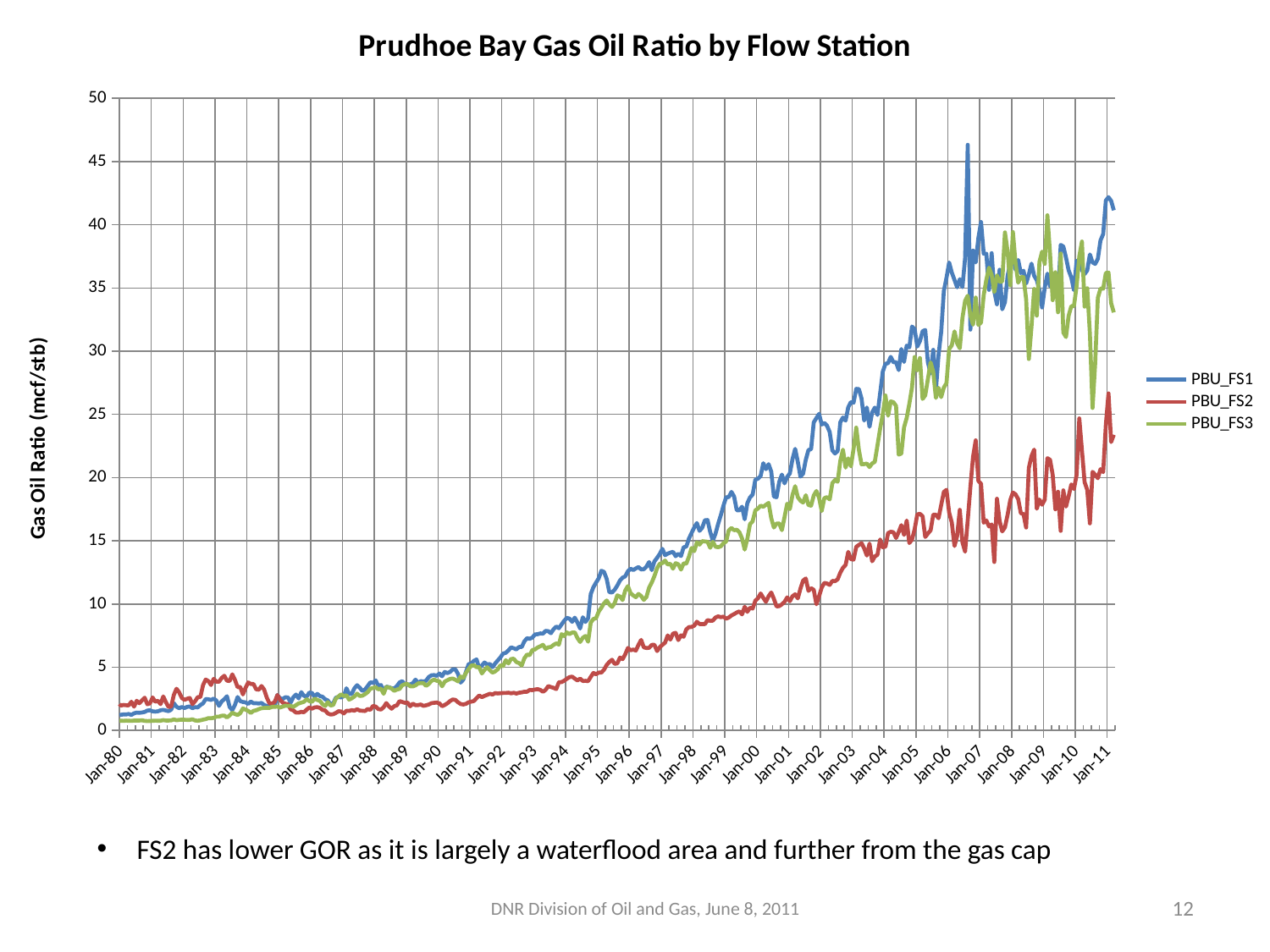
How many year labels are shown on the x axis? 32 Which series has the lowest values around Jan-10? PBU_FS2 Is the value for PBU_FS2 at Jan-11 greater or less than 20? greater What is the title of the chart? Prudhoe Bay Gas Oil Ratio by Flow Station What kind of chart is shown on the slide? line chart Do the values for PBU_FS2 generally rise or fall from Jan-80 to Jan-11? rise Is the value for PBU_FS3 at Jan-00 greater or less than 20? less Is the value for PBU_FS1 at Jan-11 greater or less than 35? greater How many series does the legend list? 3 Which series reaches the highest peak on the chart? PBU_FS1 At Jan-11, which is larger, the value for PBU_FS1 or PBU_FS2? PBU_FS1 What is the label on the vertical axis? Gas Oil Ratio (mcf/stb)